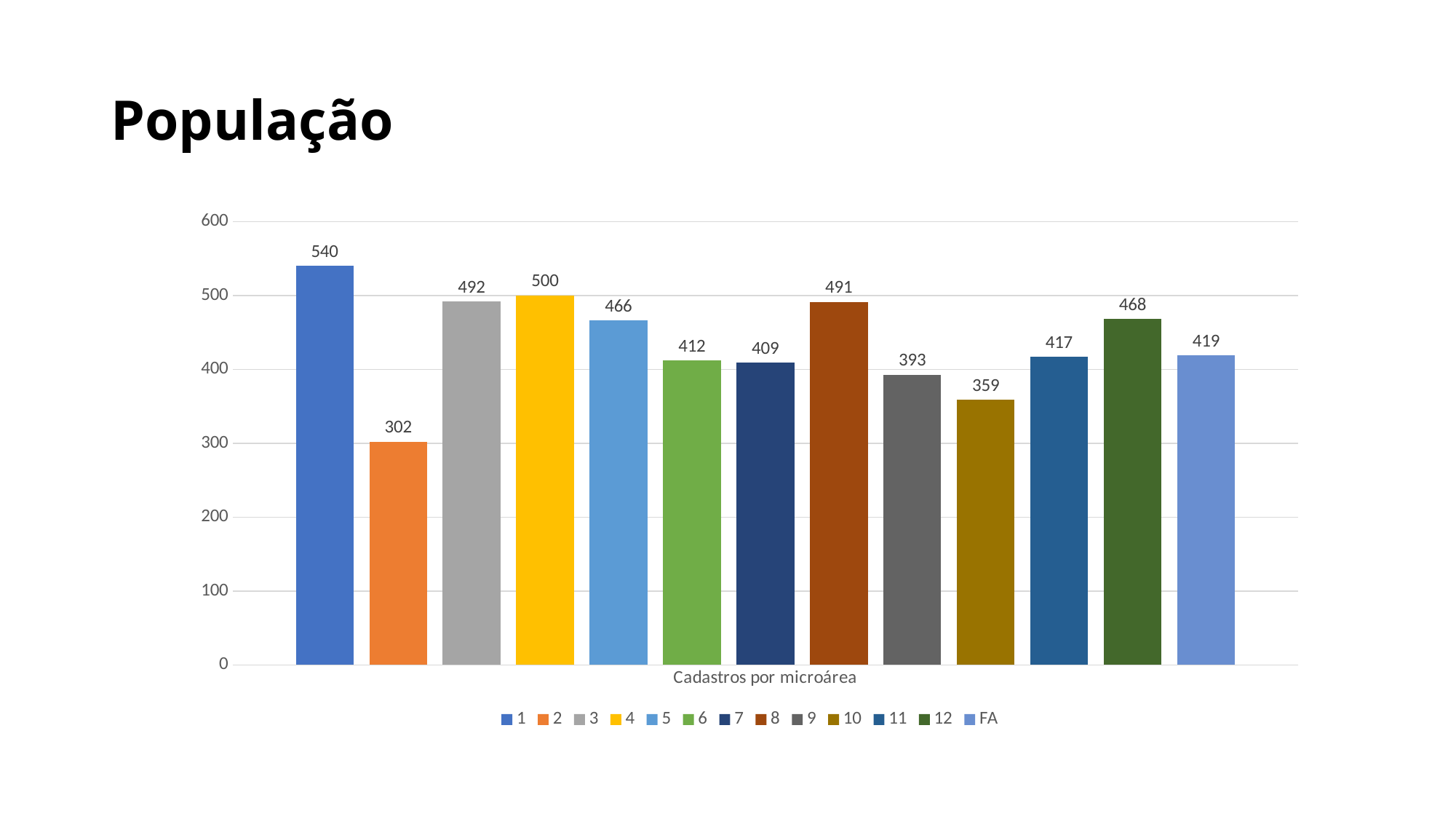
Which is larger, the value for microárea 4 or microárea 3? microárea 4 Which microárea has the lowest number of cadastros? 2 Is the value for microárea 9 greater or less than 400? less How many bars are shown in the chart? 13 How many entries does the legend list? 13 What is the title of the slide? População What is the value for microárea 1 in the Cadastros por microárea chart? 540 What is the difference between the values for microárea 1 and microárea 2? 238 Which microárea has the highest number of cadastros? 1 What is the value for FA in the Cadastros por microárea chart? 419 What is the value for microárea 10? 359 What kind of chart is shown on the slide? bar chart